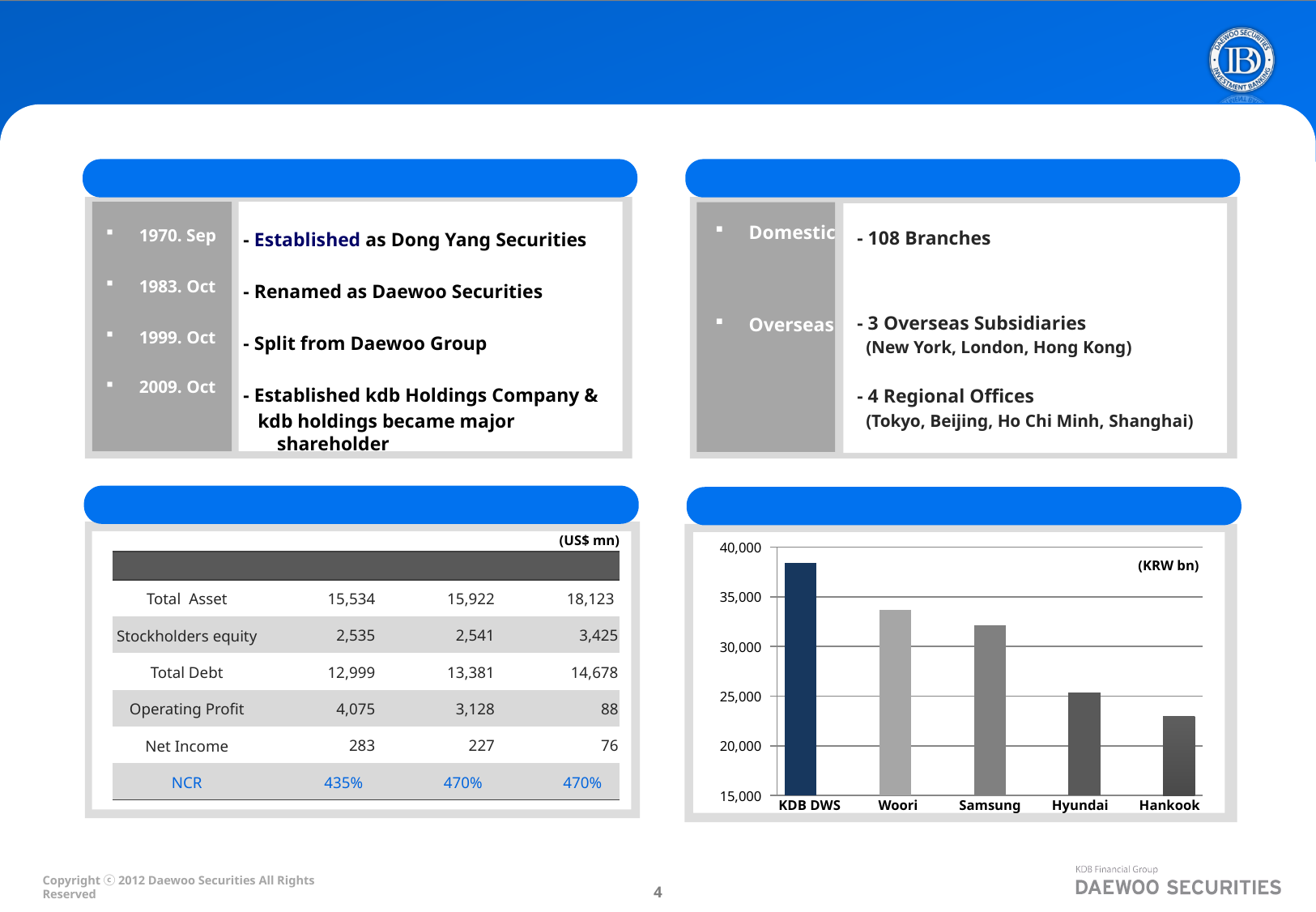
In the bar chart, is the value for Hankook greater or less than 25,000? less In the bar chart, is the value for Samsung greater or less than 30,000? greater In the bar chart, is the value for Woori greater or less than 35,000? less Which has a larger value in the bar chart, Woori or Hyundai? Woori Which company has the lowest bar in the chart? Hankook Do the bar values rise or fall moving from left to right across the chart? fall What unit is indicated in the top right corner of the bar chart's plot area? (KRW bn) How many companies are shown on the x axis of the bar chart? 5 What kind of chart is shown at the bottom right of the slide? bar chart Which company has the highest bar in the chart? KDB DWS